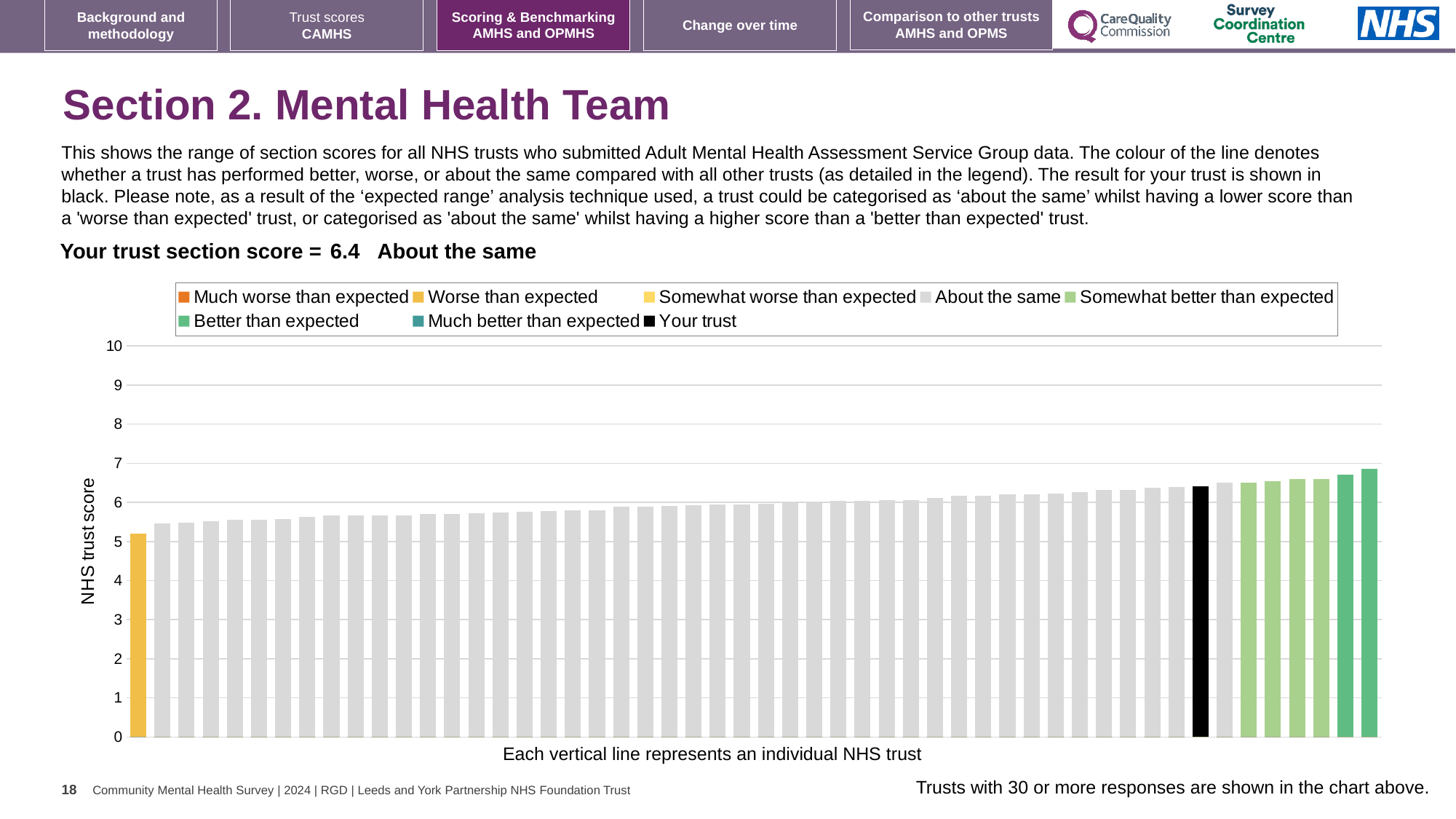
How many entries does the chart legend list? 8 Do the bar values rise or fall from left to right across the chart? rise What kind of chart is shown on the slide? bar chart What is your trust's section score for Section 2. Mental Health Team? 6.4 Which performance category is your trust placed in for Section 2. Mental Health Team? About the same What colour is used in the chart to show your trust? black Is the value of the rightmost bar greater or less than 7? less Is the value of the leftmost (yellow) bar greater or less than 6? less Is the value of the black bar (your trust) greater or less than 6? greater Which is taller, the black bar for your trust or the yellow bar at the far left? the black bar (your trust) Which legend category does the lowest bar in the chart belong to? Worse than expected What is the label on the vertical axis of the chart? NHS trust score